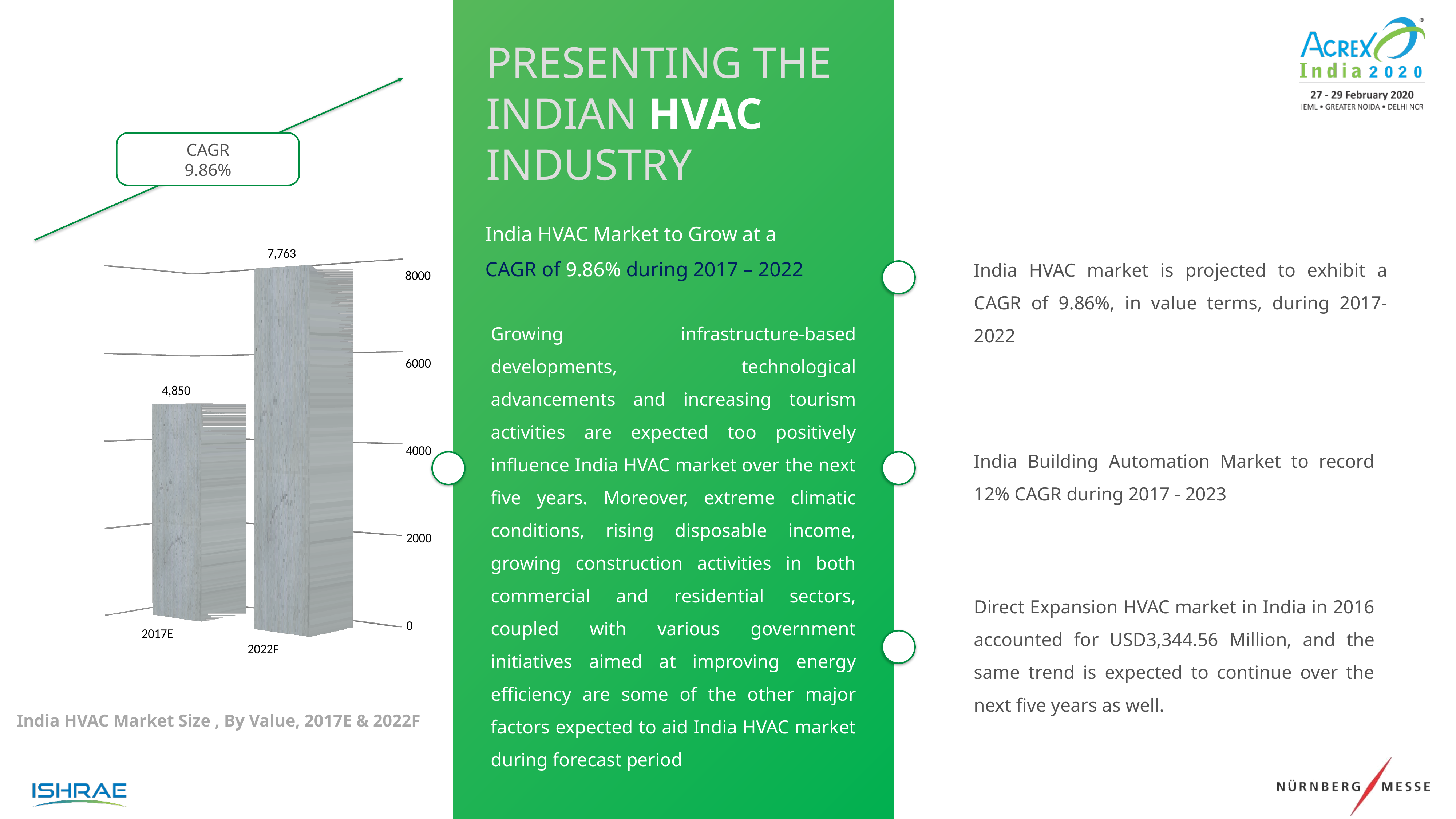
What is the value shown for 2017E? 4,850 Is the value for 2022F greater or less than 8000? less Do the values rise or fall from 2017E to 2022F? rise What is the title of the chart? India HVAC Market Size , By Value, 2017E & 2022F How many categories are shown on the chart? 2 Which category has the highest value? 2022F What is the value shown for 2022F? 7,763 What kind of chart is shown on the slide? bar chart Which category has the lowest value? 2017E Which is larger, the value for 2017E or the value for 2022F? 2022F Is the value for 2017E greater or less than 4000? greater What is the difference between the values for 2022F and 2017E? 2,913